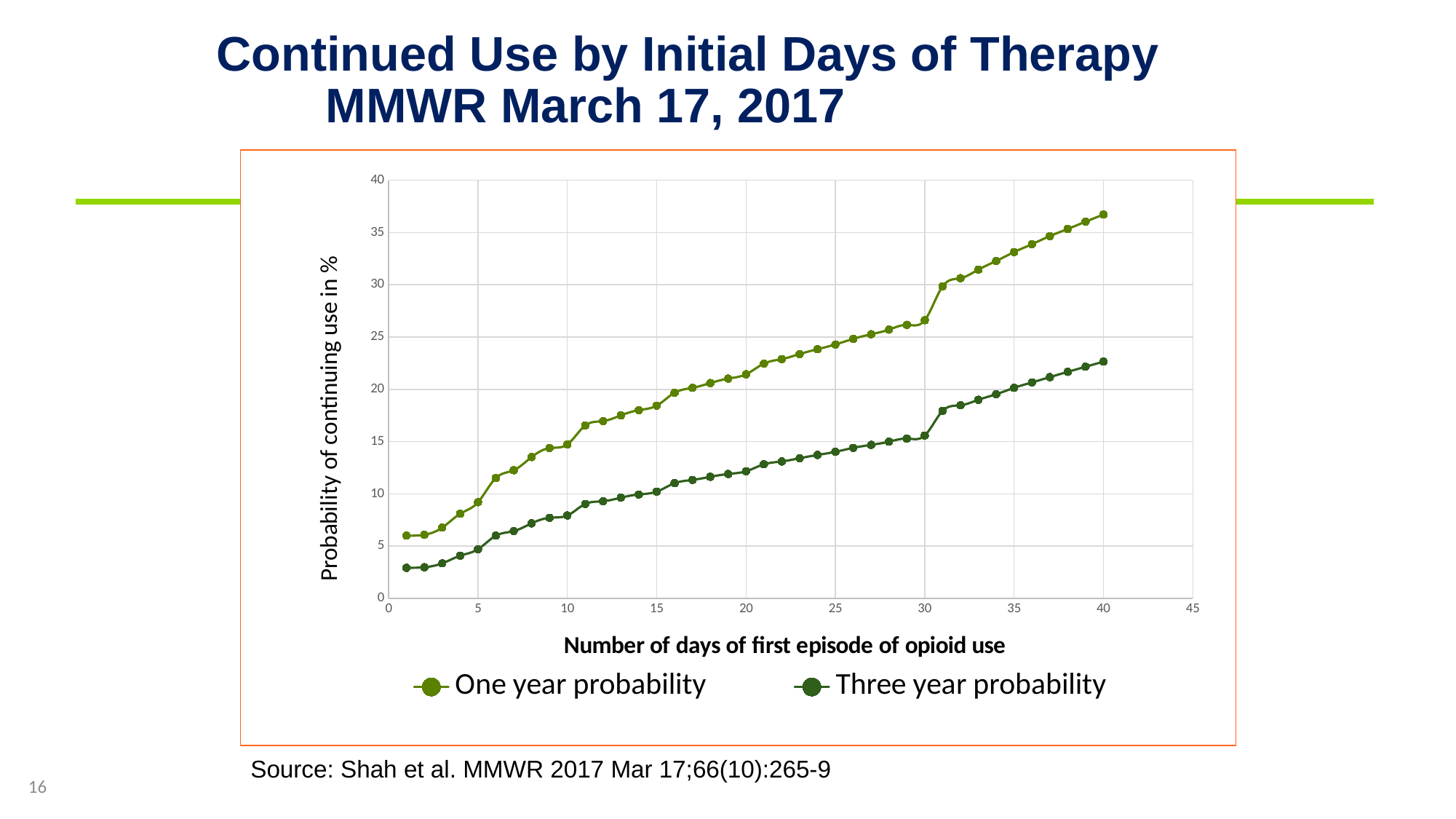
What is the title of the y axis? Probability of continuing use in % At 20 days, which series has the larger value, One year probability or Three year probability? One year probability Is the One year probability at 5 days greater or less than 10? less What kind of chart is shown on the slide? line chart Do the values for One year probability rise or fall as the number of days increases? rise Is the Three year probability at 40 days greater or less than 20? greater Do the values for Three year probability rise or fall as the number of days increases? rise Is the Three year probability at 1 day greater or less than 5? less How many series does the legend list? 2 What is the title of the x axis? Number of days of first episode of opioid use